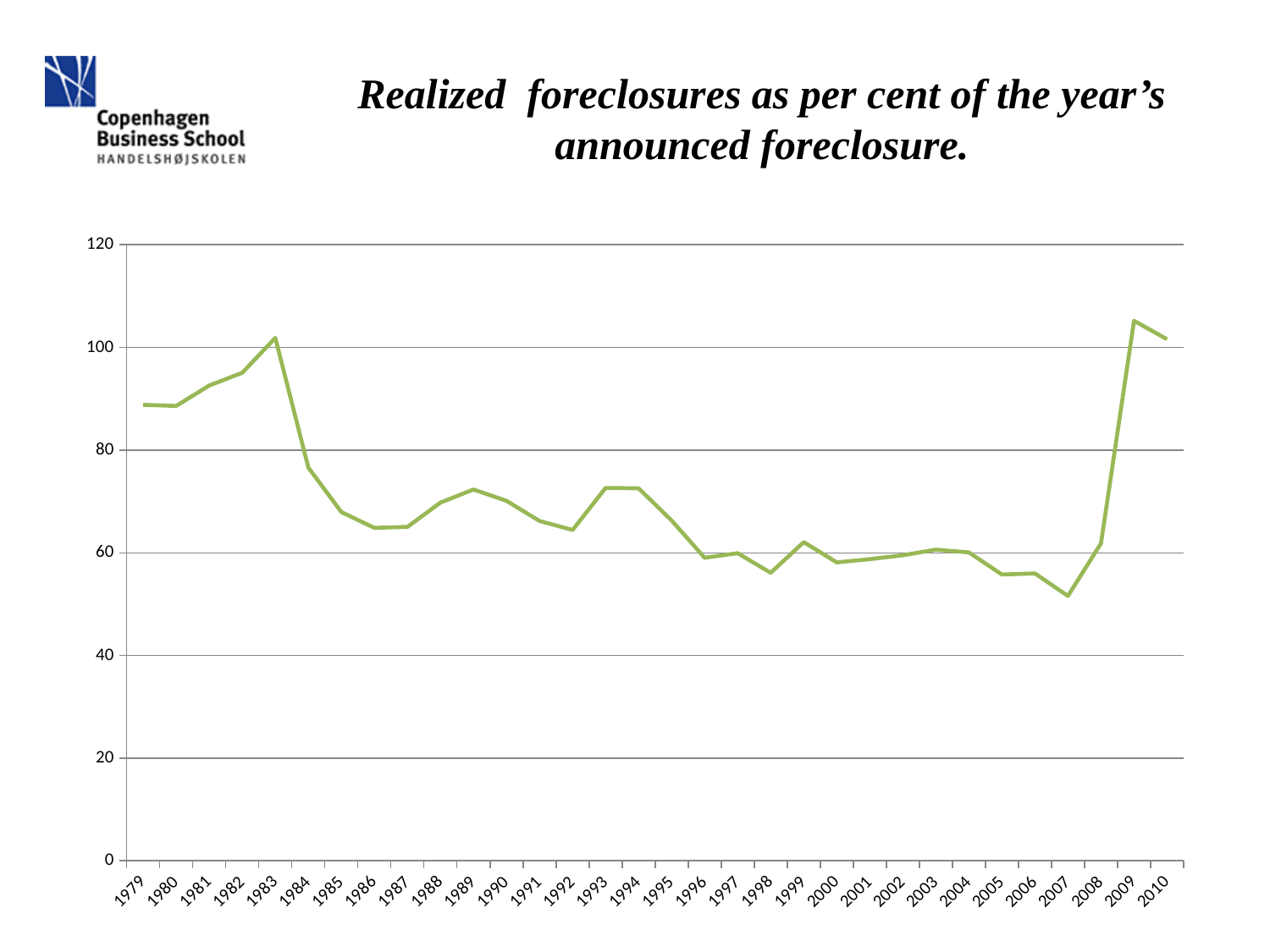
Which year has the highest value? 2009 Is the value for 2010 greater or less than 100? greater What kind of chart is shown on the slide? line chart Which year has the lowest value? 2007 Do the values rise or fall from 2007 to 2009? rise Is the value for 1985 greater or less than 80? less Is the value for 2007 greater or less than 60? less Which year has the larger value, 2009 or 2007? 2009 What is the title of the chart? Realized foreclosures as per cent of the year's announced foreclosure. How many years are plotted along the x axis? 32 Which year has the larger value, 1983 or 1996? 1983